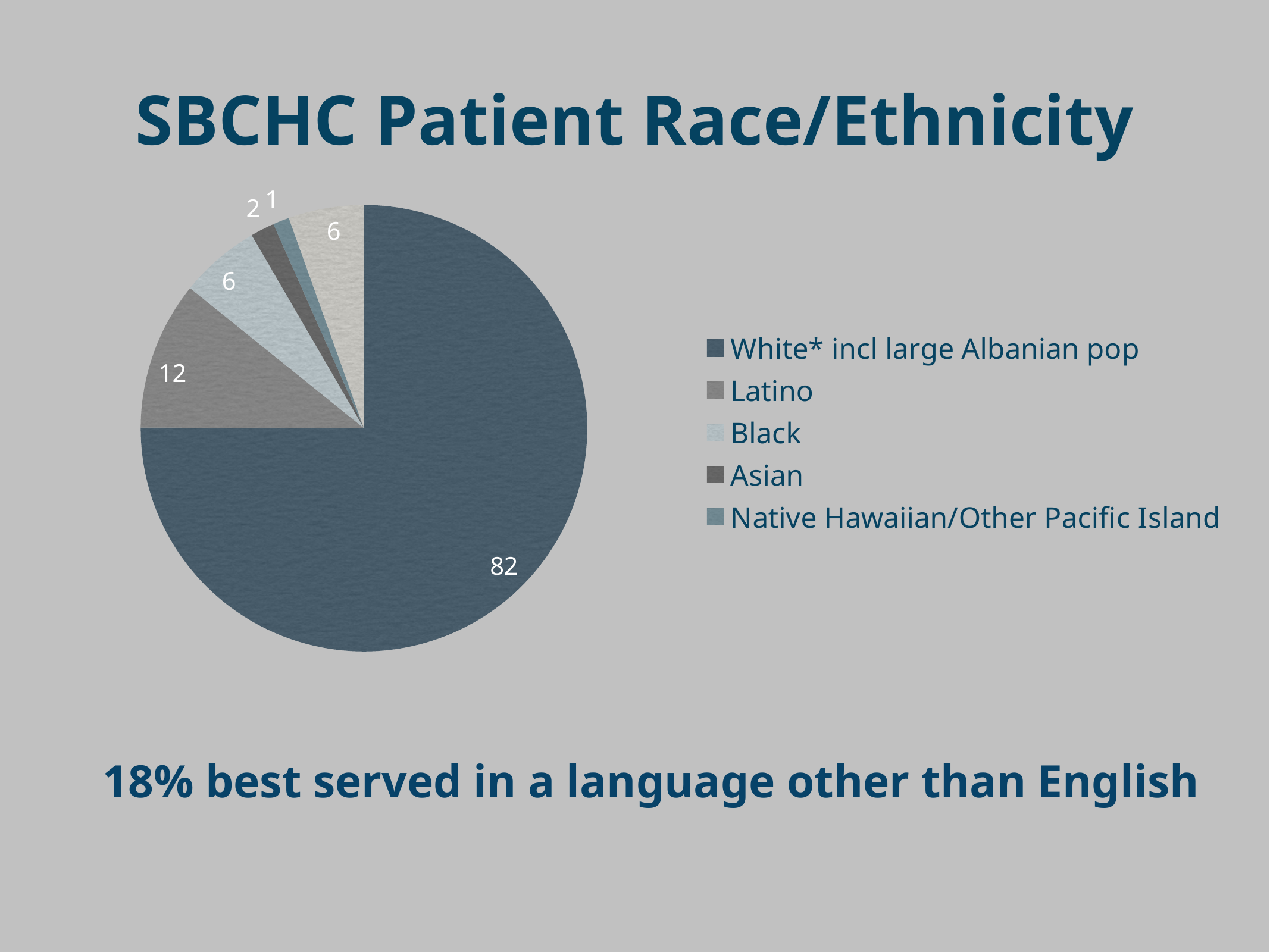
Which legend category has the smallest slice of the pie? Native Hawaiian/Other Pacific Island What is the value for Native Hawaiian/Other Pacific Island? 1 What is the title of the chart? SBCHC Patient Race/Ethnicity What is the difference between the values for White* incl large Albanian pop and Latino? 70 What is the value for Asian? 2 What is the value for Latino? 12 What kind of chart is shown on the slide? pie chart Which category has the largest slice of the pie? White* incl large Albanian pop What is the value for White* incl large Albanian pop? 82 What is the value for Black? 6 How many entries does the legend list? 5 Which is larger, the value for Latino or the value for Black? Latino